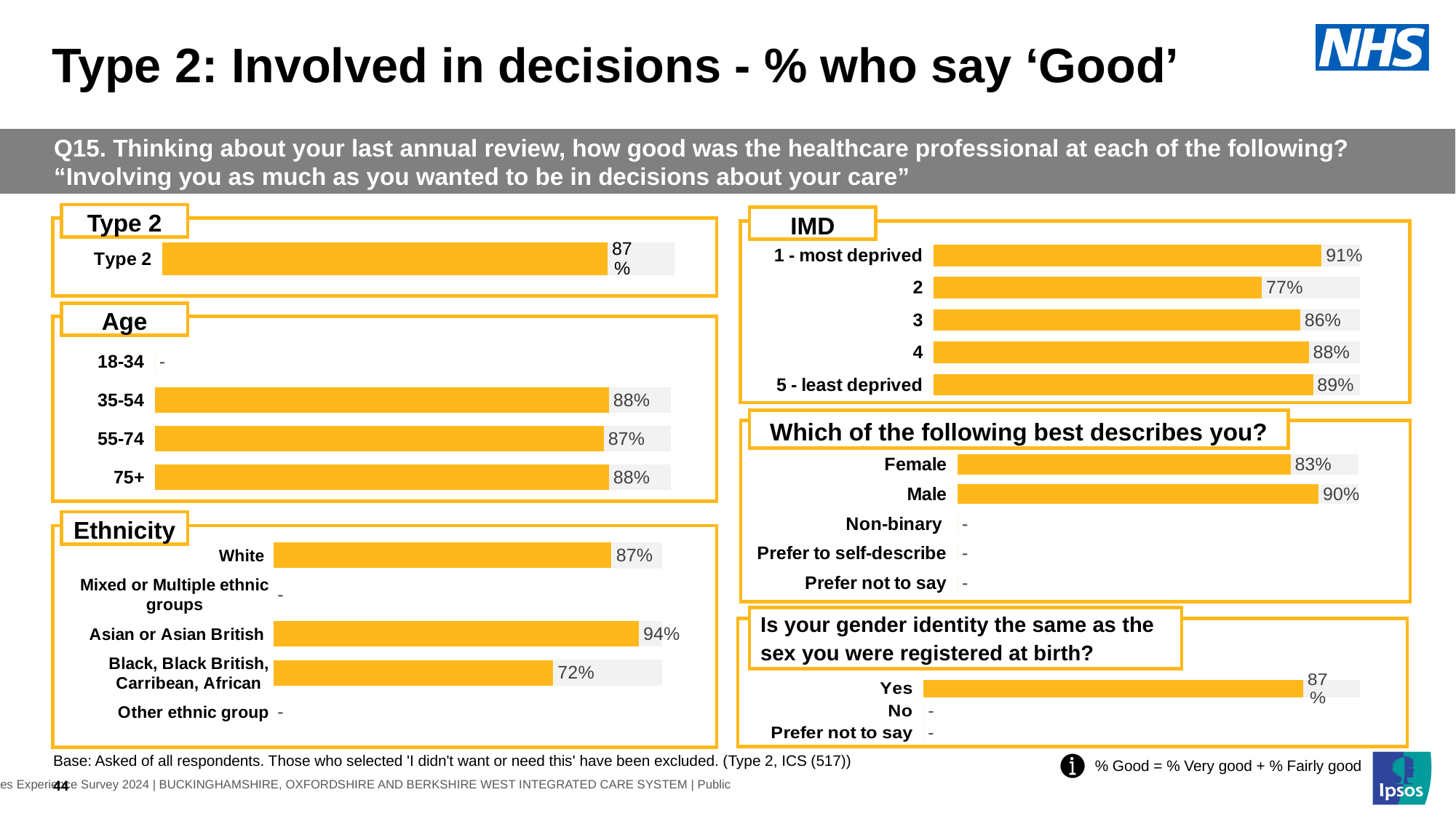
In the IMD chart, how many categories are shown? 5 In the 'Which of the following best describes you?' chart, which is larger, the value for Female or for Male? Male In the Type 2 chart, what is the value for Type 2? 87% In the Ethnicity chart, which ethnic group has the highest value? Asian or Asian British In the IMD chart, which category has the lowest value? 2 What kind of chart is the IMD chart? Bar chart In the 'Is your gender identity the same as the sex you were registered at birth?' chart, what is the value for Yes? 87% In the 'Which of the following best describes you?' chart, what is the difference between the values for Male and Female? 7 percentage points In the Age chart, what is the value for 55-74? 87% In the Ethnicity chart, what is the value for Black, Black British, Carribean, African? 72% In the Ethnicity chart, what is the difference between the values for Asian or Asian British and Black, Black British, Carribean, African? 22 percentage points In the IMD chart, what is the value for 1 - most deprived? 91%